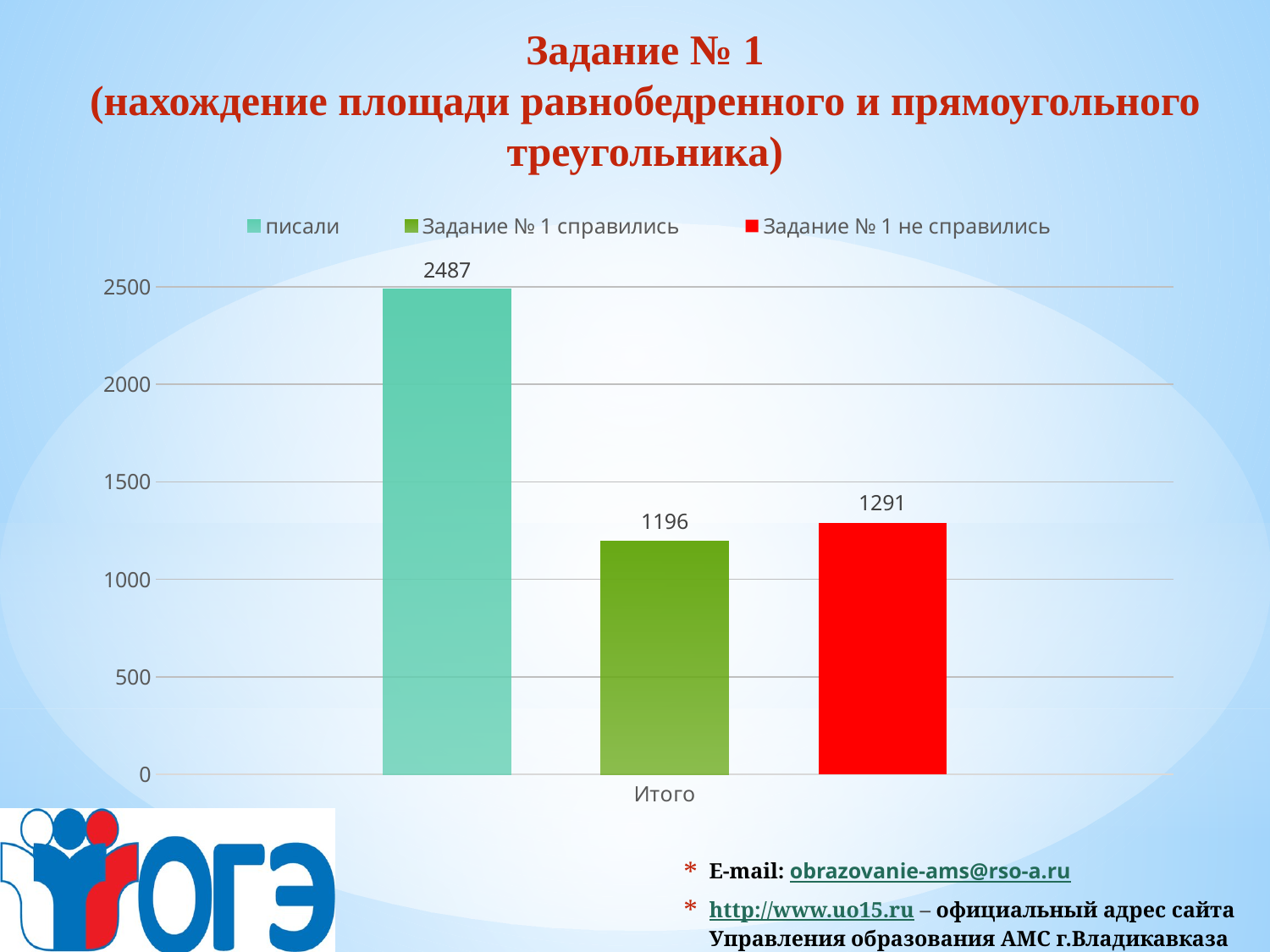
What is the category label on the x axis? Итого What is the value for the series "Задание № 1 справились"? 1196 What is the difference between the values for "Задание № 1 не справились" and "Задание № 1 справились"? 95 Which series has the lowest value? Задание № 1 справились Which is larger: the value for "Задание № 1 справились" or for "Задание № 1 не справились"? Задание № 1 не справились What is the value for the series "писали"? 2487 What kind of chart is shown on the slide? bar chart Which series has the highest value? писали What is the difference between the values for "писали" and "Задание № 1 справились"? 1291 What is the value for the series "Задание № 1 не справились"? 1291 Is the value for "писали" greater or less than 2000? greater How many series does the legend list? 3